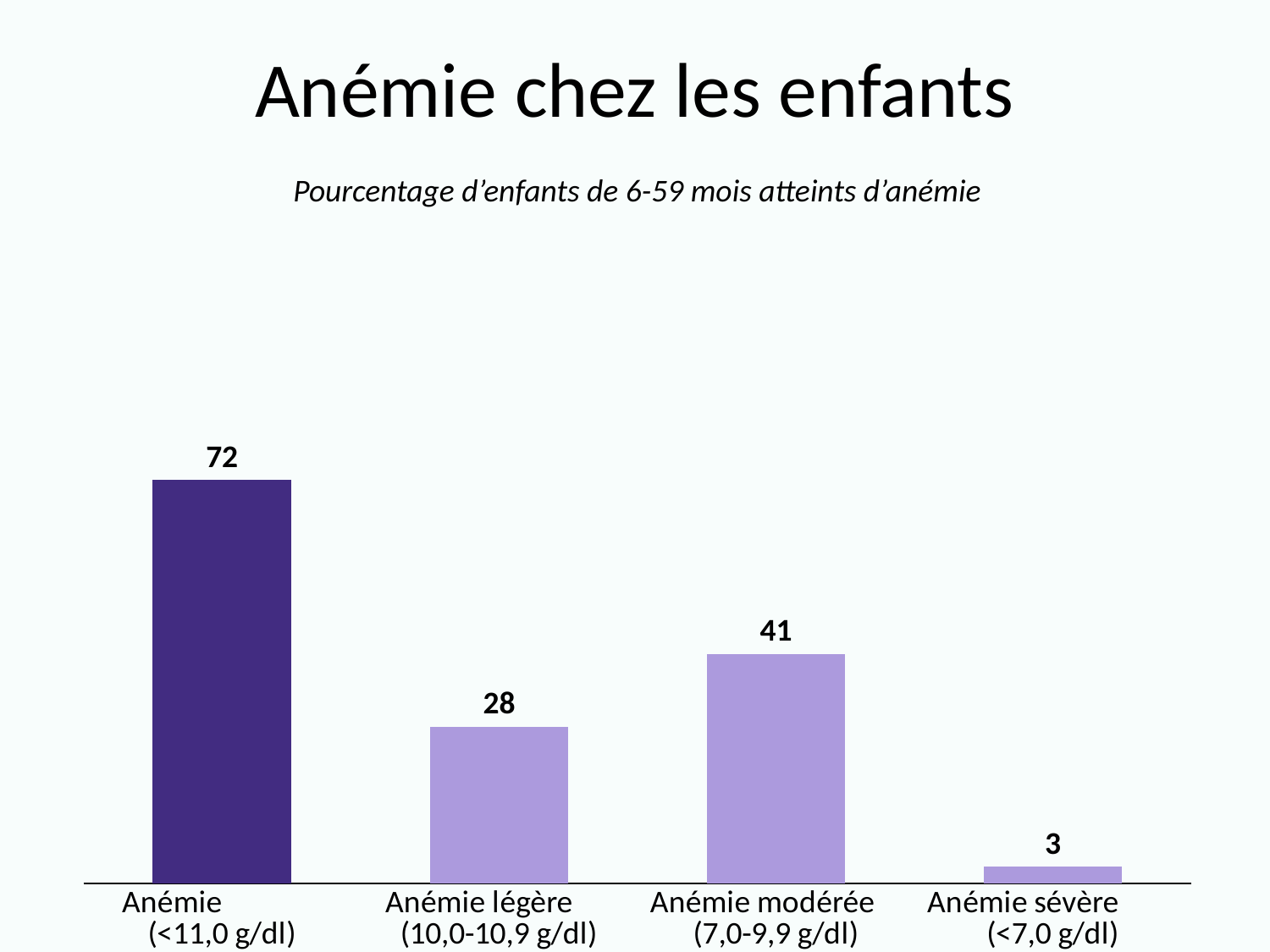
What is the value for Anémie (<11,0 g/dl)? 72 What is the subtitle shown above the chart? Pourcentage d'enfants de 6-59 mois atteints d'anémie What is the value for Anémie modérée (7,0-9,9 g/dl)? 41 Which is larger, the value for Anémie légère or the value for Anémie modérée? Anémie modérée Which category has the highest value? Anémie (<11,0 g/dl) What is the difference between the values for Anémie (<11,0 g/dl) and Anémie sévère (<7,0 g/dl)? 69 What is the value for Anémie sévère (<7,0 g/dl)? 3 What is the difference between the values for Anémie modérée and Anémie légère? 13 What kind of chart is shown on the slide? Bar chart Which category has the lowest value? Anémie sévère (<7,0 g/dl) How many categories are shown in the chart? 4 What is the value for Anémie légère (10,0-10,9 g/dl)? 28